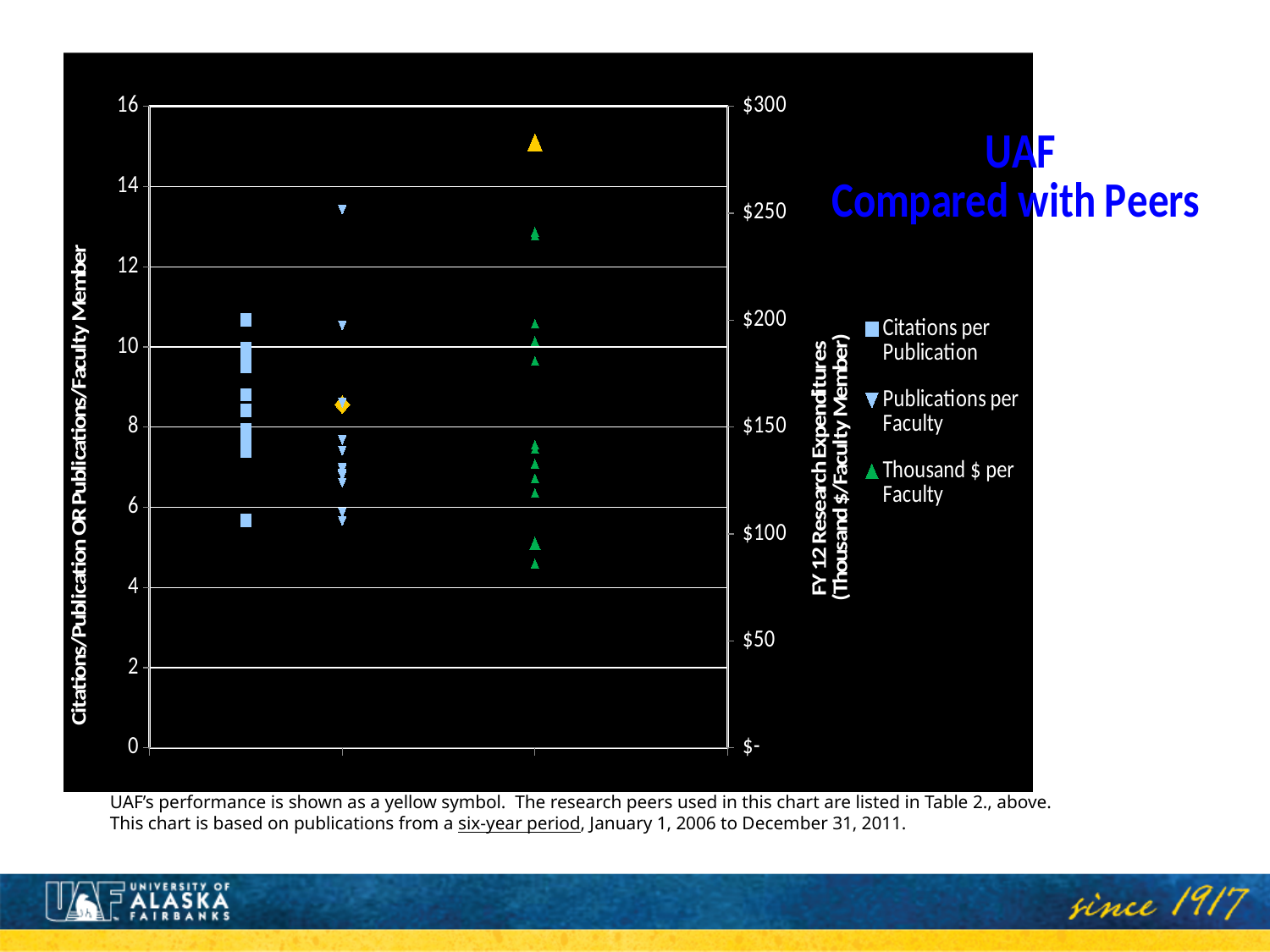
Is UAF's value for Publications per Faculty greater or less than 6? greater What is the title of the chart? UAF Compared with Peers Which colour is used to show UAF's performance in the chart? yellow What kind of chart is shown on the slide? scatter chart Which series is plotted against the right-hand axis (FY 12 Research Expenditures)? Thousand $ per Faculty What is the maximum value shown on the left vertical axis? 16 What is the maximum value shown on the right vertical axis? $300 Is the highest Citations per Publication value among the plotted points greater or less than 10? greater How many series does the legend list? 3 Is UAF's value for Thousand $ per Faculty greater or less than $250? greater